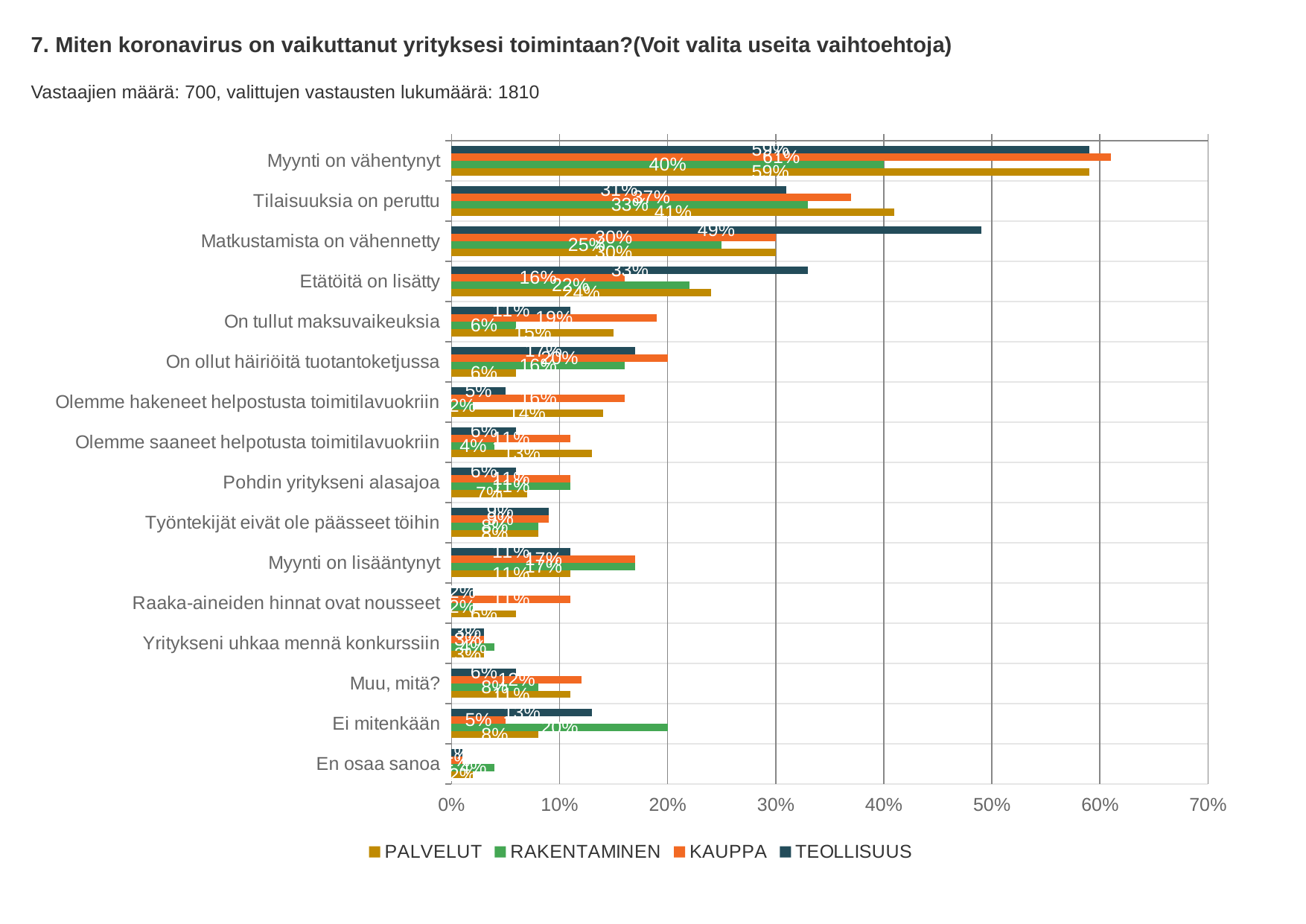
What is the RAKENTAMINEN value for 'Myynti on vähentynyt'? 40% What kind of chart is shown on the slide? Bar chart What is the difference between the KAUPPA and RAKENTAMINEN values for 'Myynti on vähentynyt'? 21 percentage points How many series does the legend list? 4 How many response categories are shown on the vertical axis? 16 What is the TEOLLISUUS value for 'Matkustamista on vähennetty'? 49% What is the RAKENTAMINEN value for 'Ei mitenkään'? 20% Which series has the highest value for 'Matkustamista on vähennetty'? TEOLLISUUS Is the TEOLLISUUS value for 'Etätöitä on lisätty' greater or less than 30%? greater What is the KAUPPA value for 'Myynti on vähentynyt'? 61% For 'Tilaisuuksia on peruttu', which is larger: the PALVELUT value or the TEOLLISUUS value? PALVELUT Which series has the lowest value for 'On tullut maksuvaikeuksia'? RAKENTAMINEN